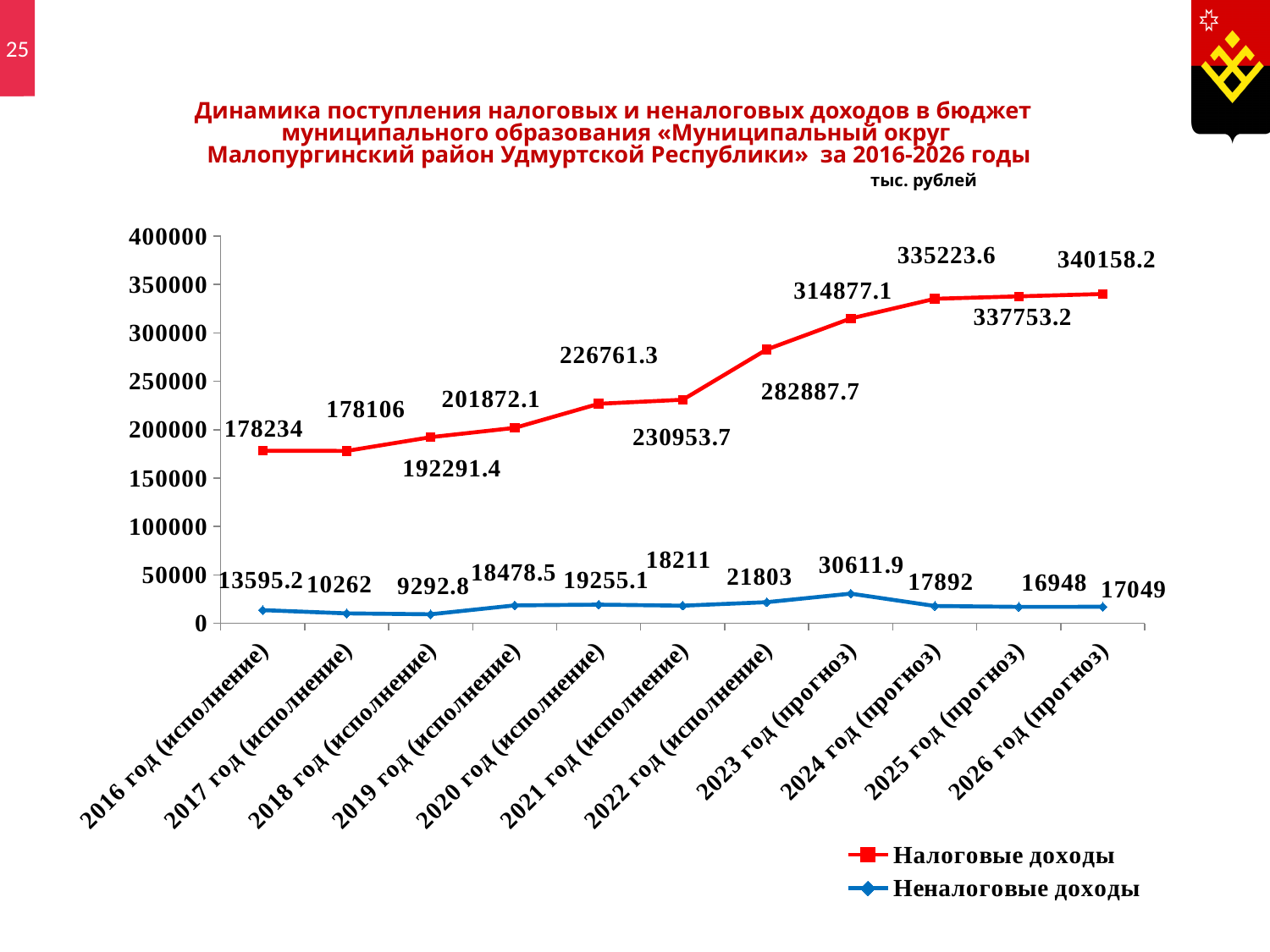
What is the value of Неналоговые доходы for 2023 год (прогноз)? 30611.9 How many series does the legend list? 2 In which year is Неналоговые доходы lowest? 2018 год (исполнение) What is the difference between Налоговые доходы in 2026 год (прогноз) and in 2016 год (исполнение)? 161924.2 What is the value of Налоговые доходы for 2020 год (исполнение)? 226761.3 How many years are shown on the x axis? 11 What kind of chart is shown on the slide? Line chart What is the value of Налоговые доходы for 2024 год (прогноз)? 335223.6 Which is larger: Неналоговые доходы in 2019 год (исполнение) or in 2017 год (исполнение)? 2019 год (исполнение) In which year is Неналоговые доходы highest? 2023 год (прогноз) Do the values of Налоговые доходы generally rise or fall from 2016 to 2026? Rise In which year is Налоговые доходы highest? 2026 год (прогноз)